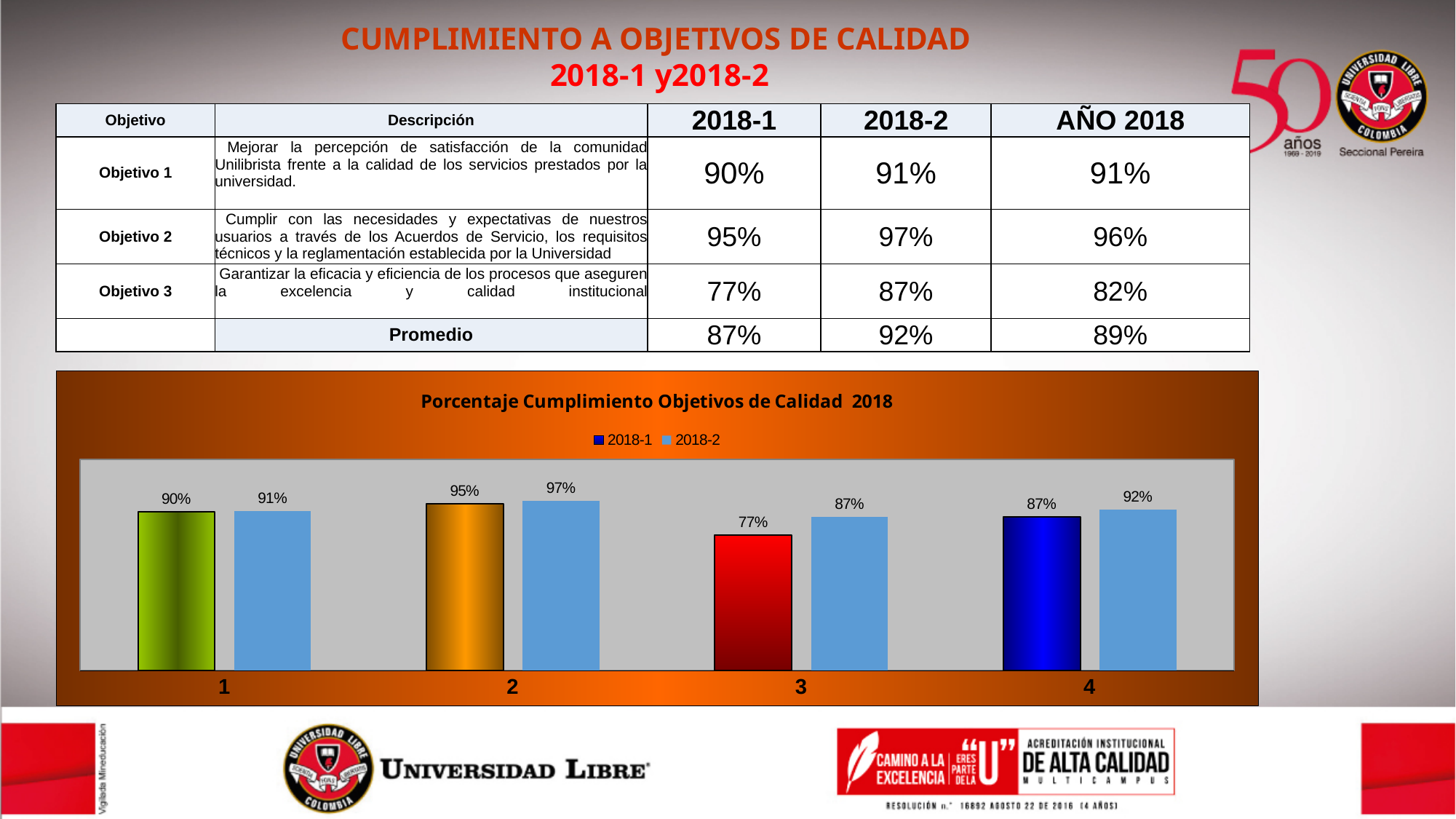
How many series does the chart legend list? 2 What is the 2018-1 value for category 4? 87% How many categories are shown on the x axis of the chart? 4 Do the 2018-1 values rise or fall from category 2 to category 3? fall What is the 2018-2 value for category 2? 97% What type of chart is shown on the slide? bar chart Which category has the lowest 2018-1 value? 3 What is the difference between the 2018-2 and 2018-1 values for category 3? 10% For category 1, which series has the larger value, 2018-1 or 2018-2? 2018-2 Which category has the highest 2018-2 value? 2 What is the 2018-1 value for category 3? 77% What is the title of the chart? Porcentaje Cumplimiento Objetivos de Calidad 2018